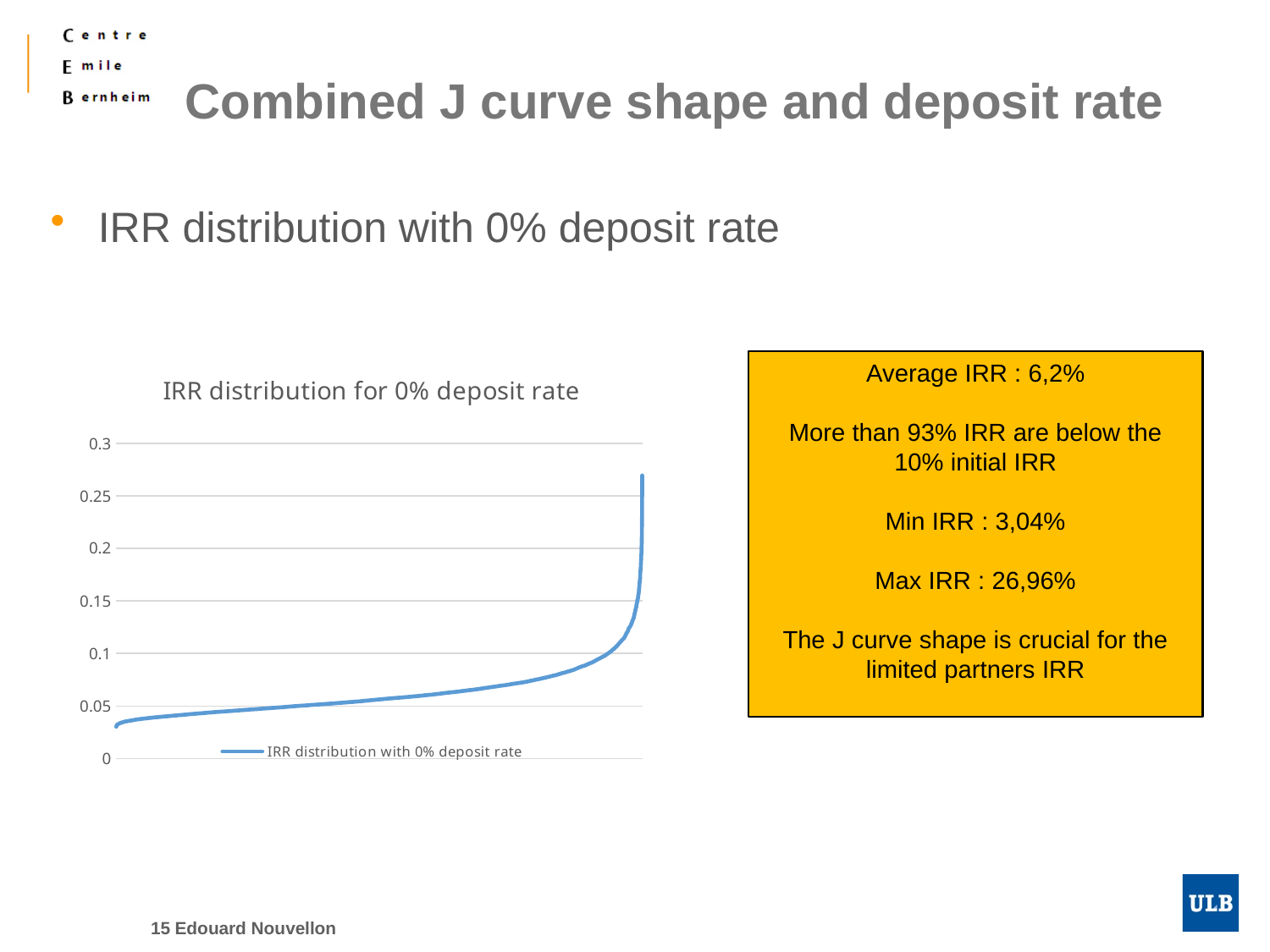
Is the highest value reached by the line at the right end of the chart greater or less than 0.25? greater What is the title of the chart? IRR distribution for 0% deposit rate Do the values of the line rise or fall from left to right along the x axis? rise What kind of chart is shown on the slide? line chart Is the highest value reached by the line greater or less than 0.3? less Is the value of the line at the left end of the chart greater or less than 0.05? less How many series does the legend of the chart list? 1 What is the series name shown in the chart legend? IRR distribution with 0% deposit rate